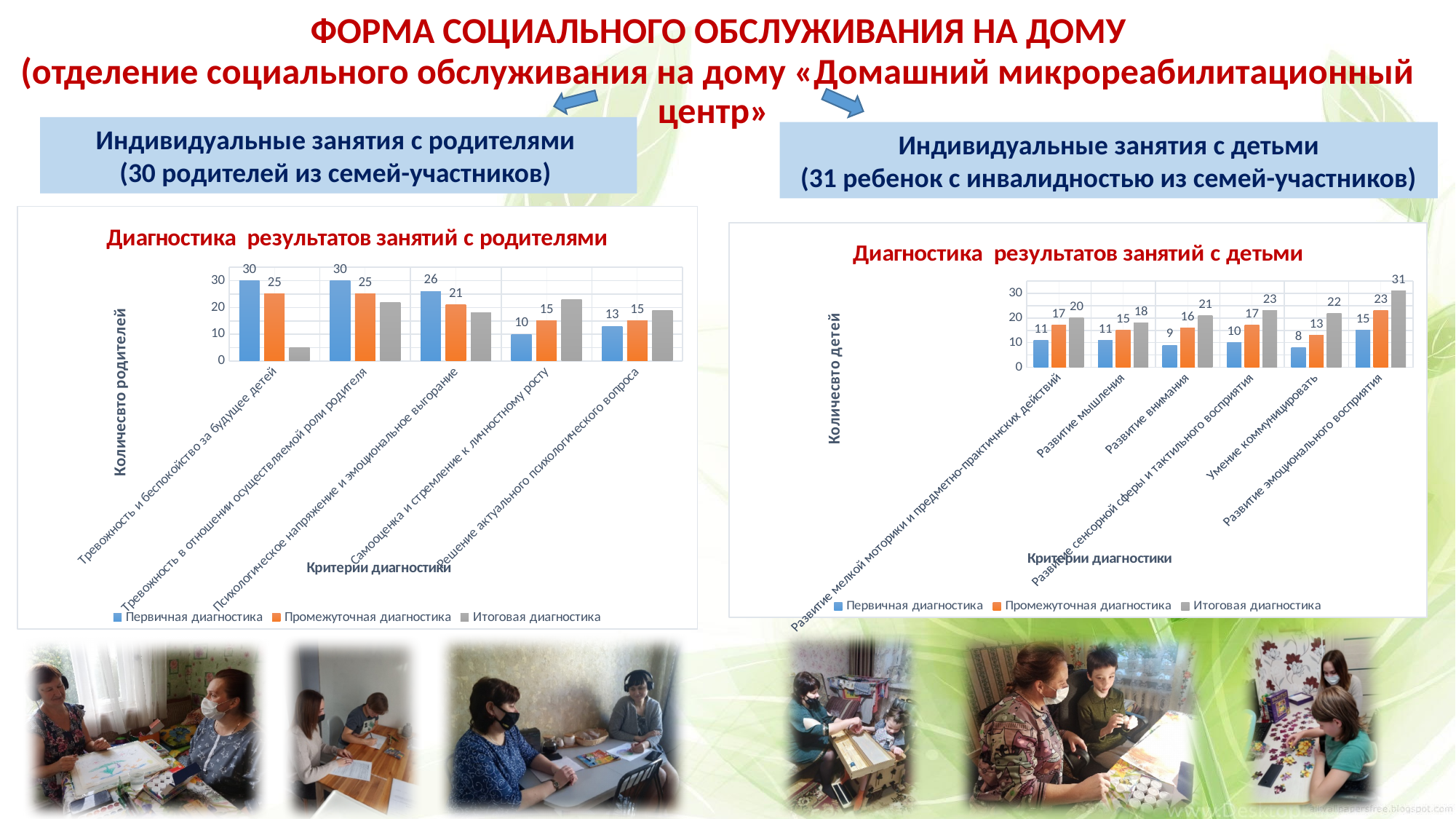
How many series does the legend list on the chart 'Диагностика результатов занятий с родителями'? 3 What type of chart is 'Диагностика результатов занятий с детьми'? Bar chart On the chart 'Диагностика результатов занятий с родителями', is the 'Итоговая диагностика' value for 'Тревожность и беспокойство за будущее детей' greater or less than 10? less On the chart 'Диагностика результатов занятий с детьми', what is the value of 'Первичная диагностика' for 'Умение коммуницировать'? 8 On the chart 'Диагностика результатов занятий с детьми', which category has the highest 'Итоговая диагностика' value? Развитие эмоционального восприятия On the chart 'Диагностика результатов занятий с детьми', which category has the lowest 'Первичная диагностика' value? Умение коммуницировать How many categories are shown on the chart 'Диагностика результатов занятий с детьми'? 6 On the chart 'Диагностика результатов занятий с родителями', which is larger for 'Самооценка и стремление к личностному росту': 'Первичная диагностика' or 'Промежуточная диагностика'? Промежуточная диагностика On the chart 'Диагностика результатов занятий с детьми', what is the difference between 'Итоговая диагностика' and 'Первичная диагностика' for 'Развитие внимания'? 12 On the chart 'Диагностика результатов занятий с родителями', what is the value of 'Промежуточная диагностика' for 'Психологическое напряжение и эмоциональное выгорание'? 21 On the chart 'Диагностика результатов занятий с родителями', is the 'Итоговая диагностика' value for 'Самооценка и стремление к личностному росту' greater or less than 20? greater On the chart 'Диагностика результатов занятий с детьми', what is the value of 'Итоговая диагностика' for 'Развитие эмоционального восприятия'? 31